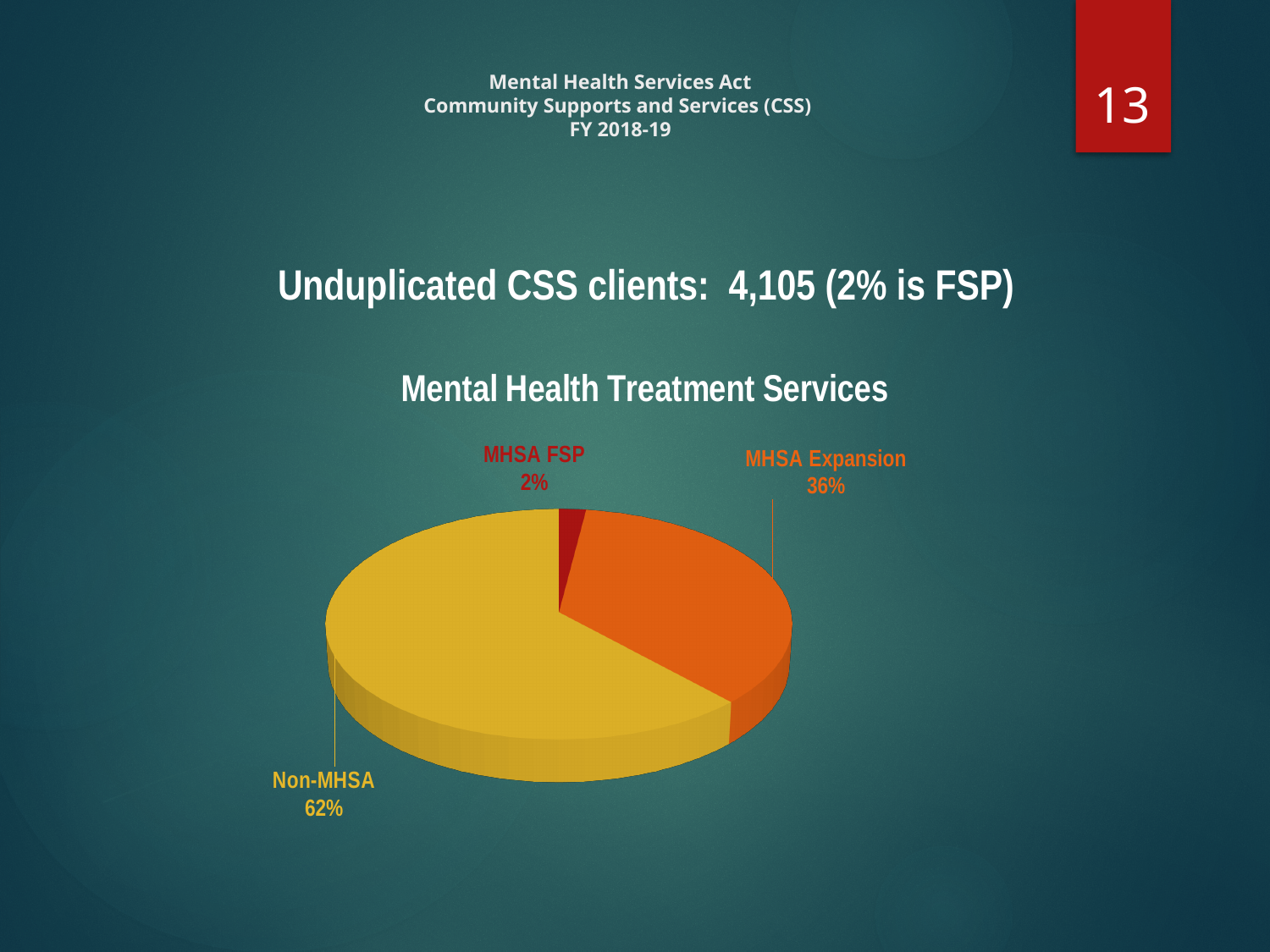
Which slice of the pie is the largest? Non-MHSA What is the title of the chart? Mental Health Treatment Services What kind of chart is shown on the slide? Pie chart What is the difference in percentage points between the Non-MHSA and MHSA Expansion slices? 26 What share of the pie does MHSA FSP represent? 2% Which is larger, the MHSA Expansion slice or the MHSA FSP slice? MHSA Expansion What colour is the Non-MHSA slice? Yellow What is the combined share of the MHSA Expansion and MHSA FSP slices? 38% Which slice of the pie is the smallest? MHSA FSP What share of the pie does MHSA Expansion represent? 36% How many slices does the pie chart have? 3 What share of the pie does Non-MHSA represent? 62%